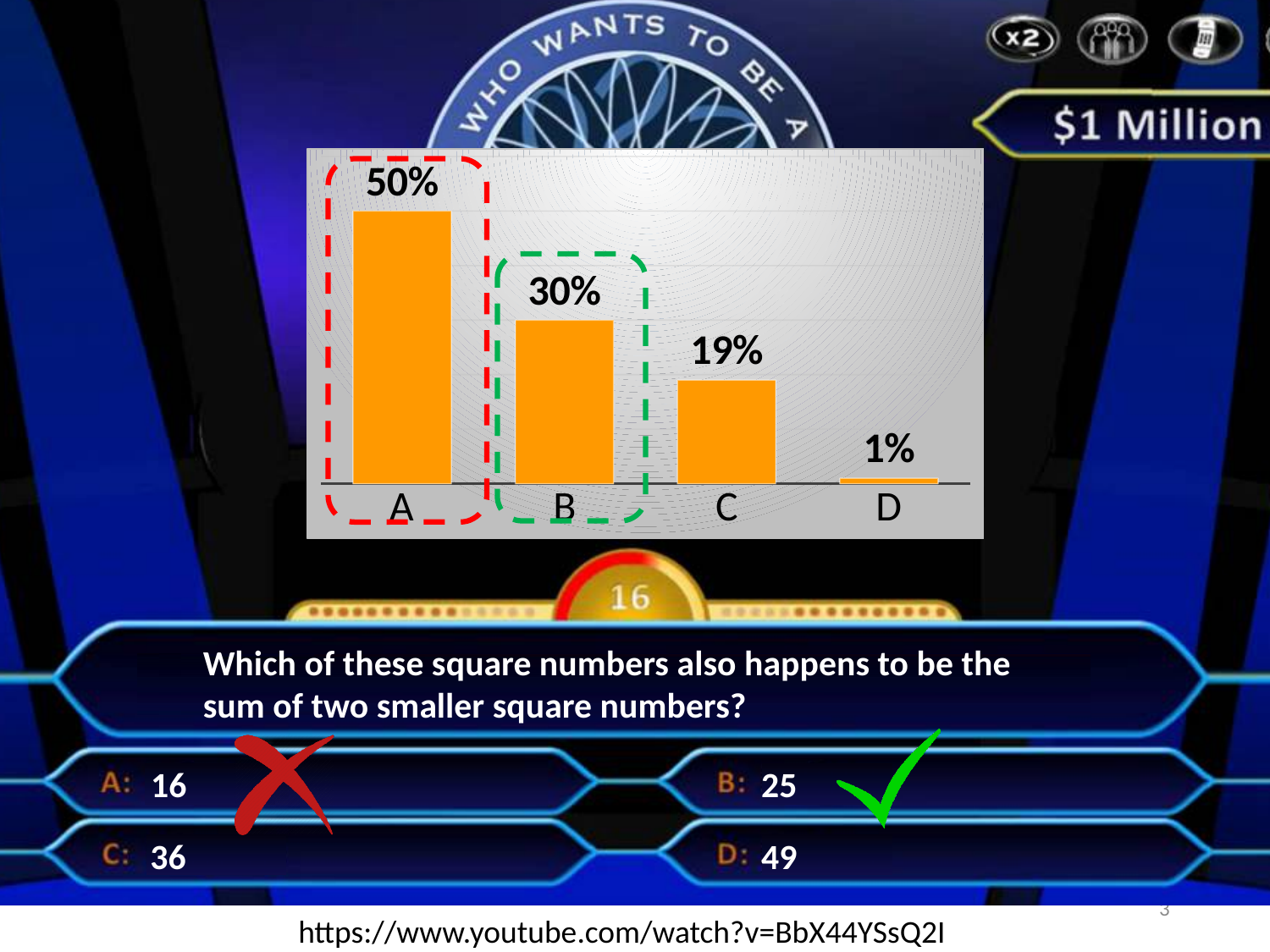
What is the value for category B? 30% Which category has the highest value? A Do the values rise or fall from A to D along the x axis? Fall How many categories are shown in the chart? 4 What kind of chart is shown on the slide? Bar chart What is the value for category A? 50% What is the value for category D? 1% What is the value for category C? 19% What is the difference between the values for C and D? 18% Which category has the lowest value? D What is the difference between the values for A and B? 20% Which is larger, the value for B or the value for C? B